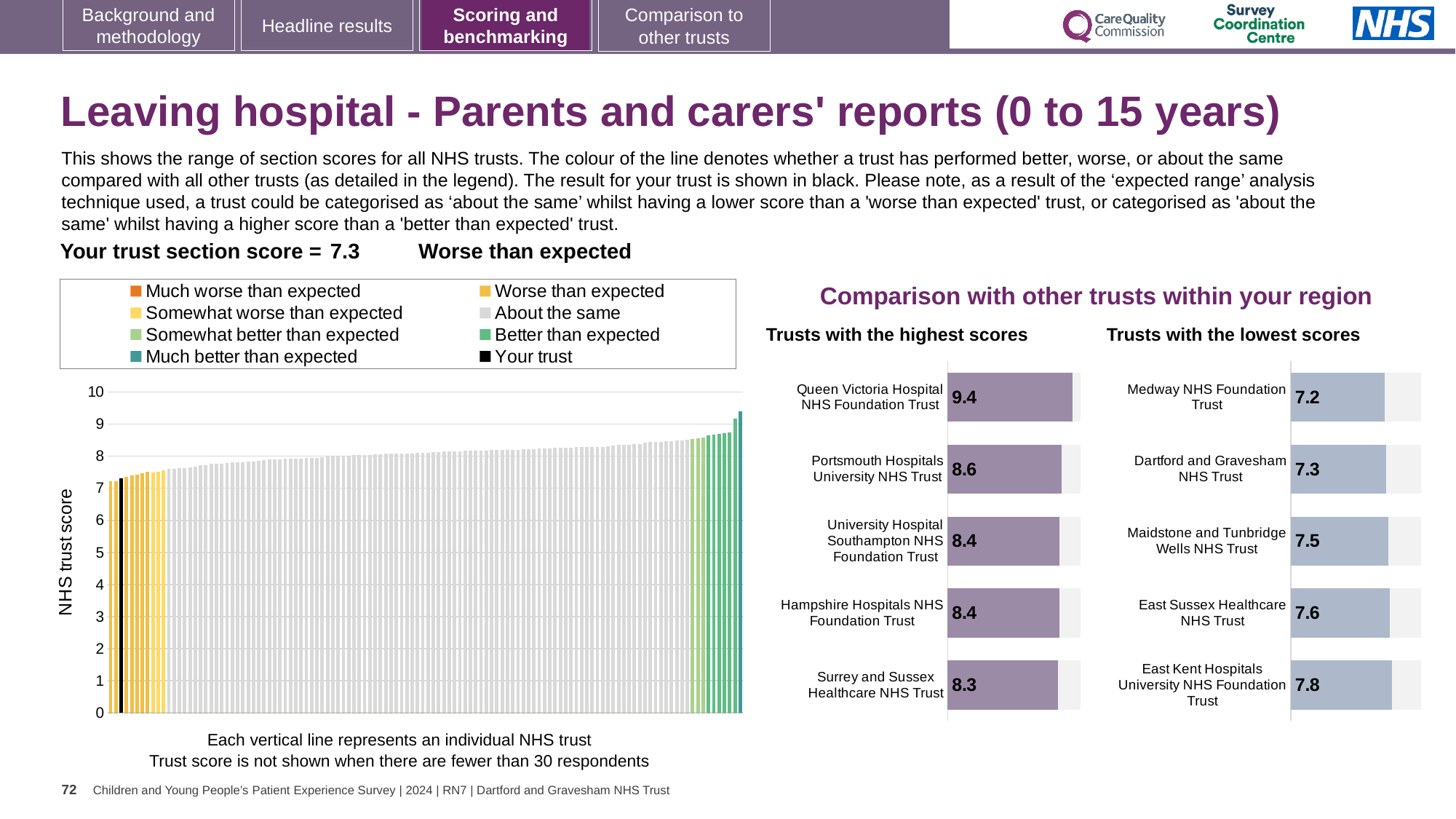
Which has the higher score: Portsmouth Hospitals University NHS Trust in the highest scores chart or Maidstone and Tunbridge Wells NHS Trust in the lowest scores chart? Portsmouth Hospitals University NHS Trust How many trusts are listed in the 'Trusts with the highest scores' chart? 5 What kind of chart is the NHS trust score chart on the left of the slide? bar chart In the 'Trusts with the highest scores' chart, what is the score for Queen Victoria Hospital NHS Foundation Trust? 9.4 How many entries does the legend of the NHS trust score chart on the left list? 8 In the NHS trust score chart on the left, do the values rise or fall from left to right? rise In the 'Trusts with the lowest scores' chart, what is the score for Medway NHS Foundation Trust? 7.2 In the 'Trusts with the lowest scores' chart, how much higher is East Kent Hospitals University NHS Foundation Trust's score than Medway NHS Foundation Trust's? 0.6 In the 'Trusts with the highest scores' chart, which trust has the highest score? Queen Victoria Hospital NHS Foundation Trust In the 'Trusts with the lowest scores' chart, which trust has the lowest score? Medway NHS Foundation Trust In the 'Trusts with the highest scores' chart, what is the difference between the scores of Queen Victoria Hospital NHS Foundation Trust and Surrey and Sussex Healthcare NHS Trust? 1.1 In the NHS trust score chart on the left, what is the section score for your trust? 7.3